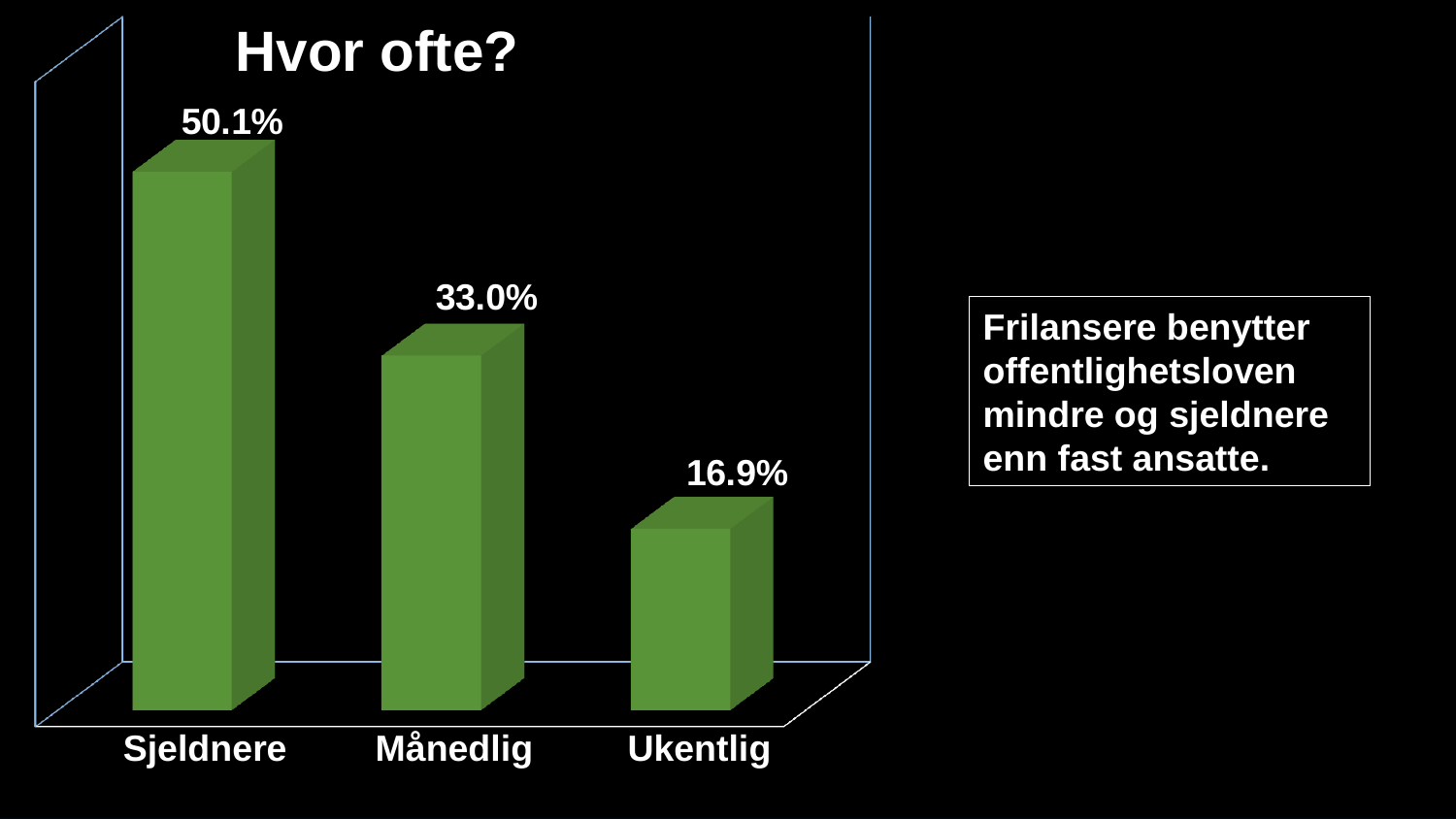
Which category has the lowest value? Ukentlig Do the values rise or fall from left to right along the x axis? Fall Which is larger, the value for Månedlig or the value for Ukentlig? Månedlig Which category has the highest value? Sjeldnere What kind of chart is this? Bar chart What is the title of the chart? Hvor ofte? What is the difference between the values for Sjeldnere and Månedlig? 17.1% What is the value for Ukentlig? 16.9% What is the value for Månedlig? 33.0% What is the value for Sjeldnere? 50.1% What is the difference between the values for Månedlig and Ukentlig? 16.1% How many categories are shown in the chart? 3